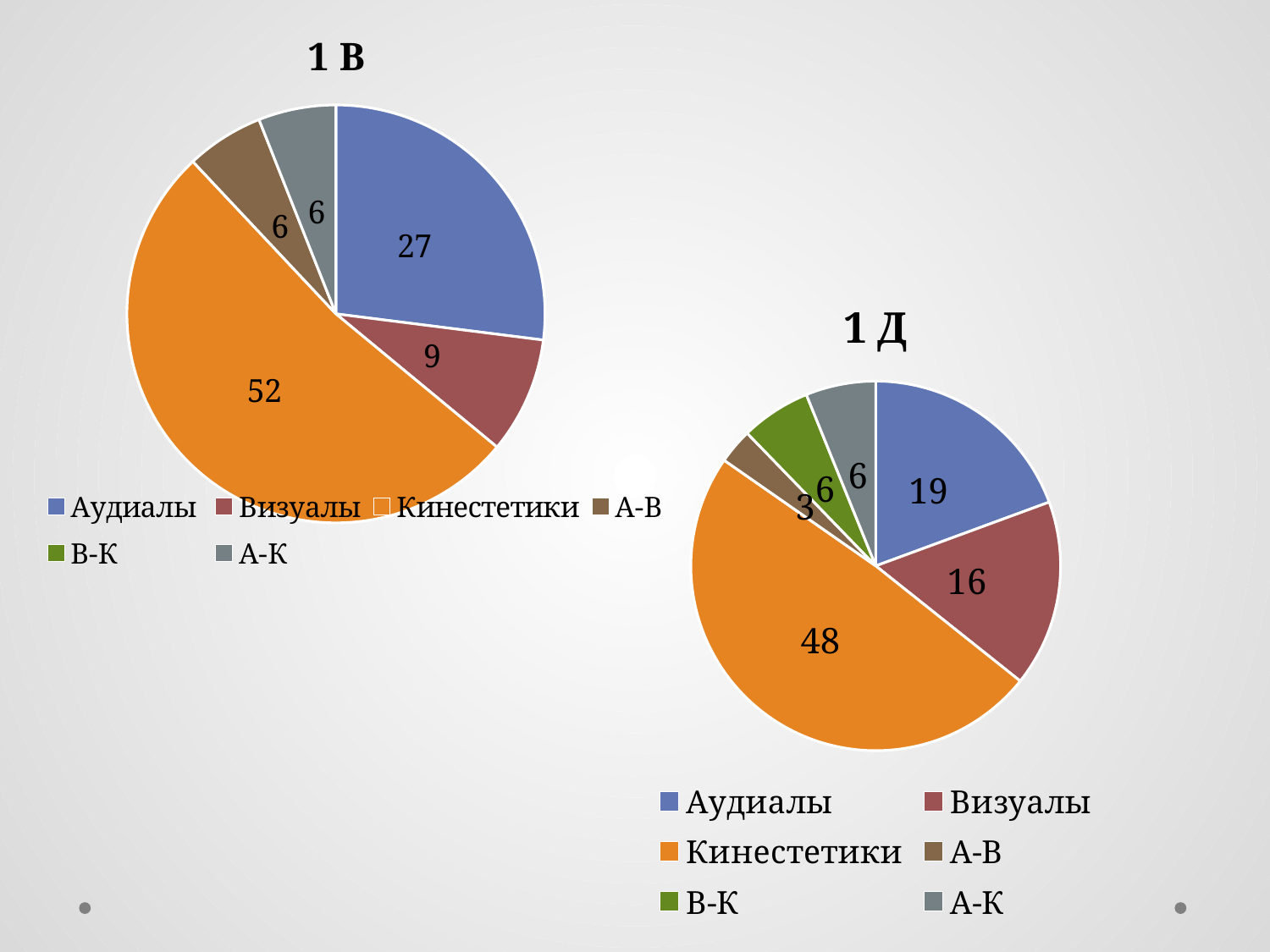
In the chart titled "1 Д", which category has the largest slice? Кинестетики What kind of chart is the chart titled "1 Д"? Pie chart What is the title of the chart on the left of the slide? 1 В In the chart titled "1 В", what is the value for Кинестетики? 52 In the chart titled "1 Д", which category has the smallest slice? А-В In the chart titled "1 Д", which is larger, Аудиалы or Визуалы? Аудиалы How many slices does the chart titled "1 Д" have? 6 In the chart titled "1 В", which category has the largest slice? Кинестетики In the chart titled "1 Д", what is the value for Визуалы? 16 In the chart titled "1 В", what is the value for А-В? 6 In the chart titled "1 В", what is the difference between the values for Аудиалы and Визуалы? 18 What is the difference between the Кинестетики value in the chart titled "1 В" and the Кинестетики value in the chart titled "1 Д"? 4